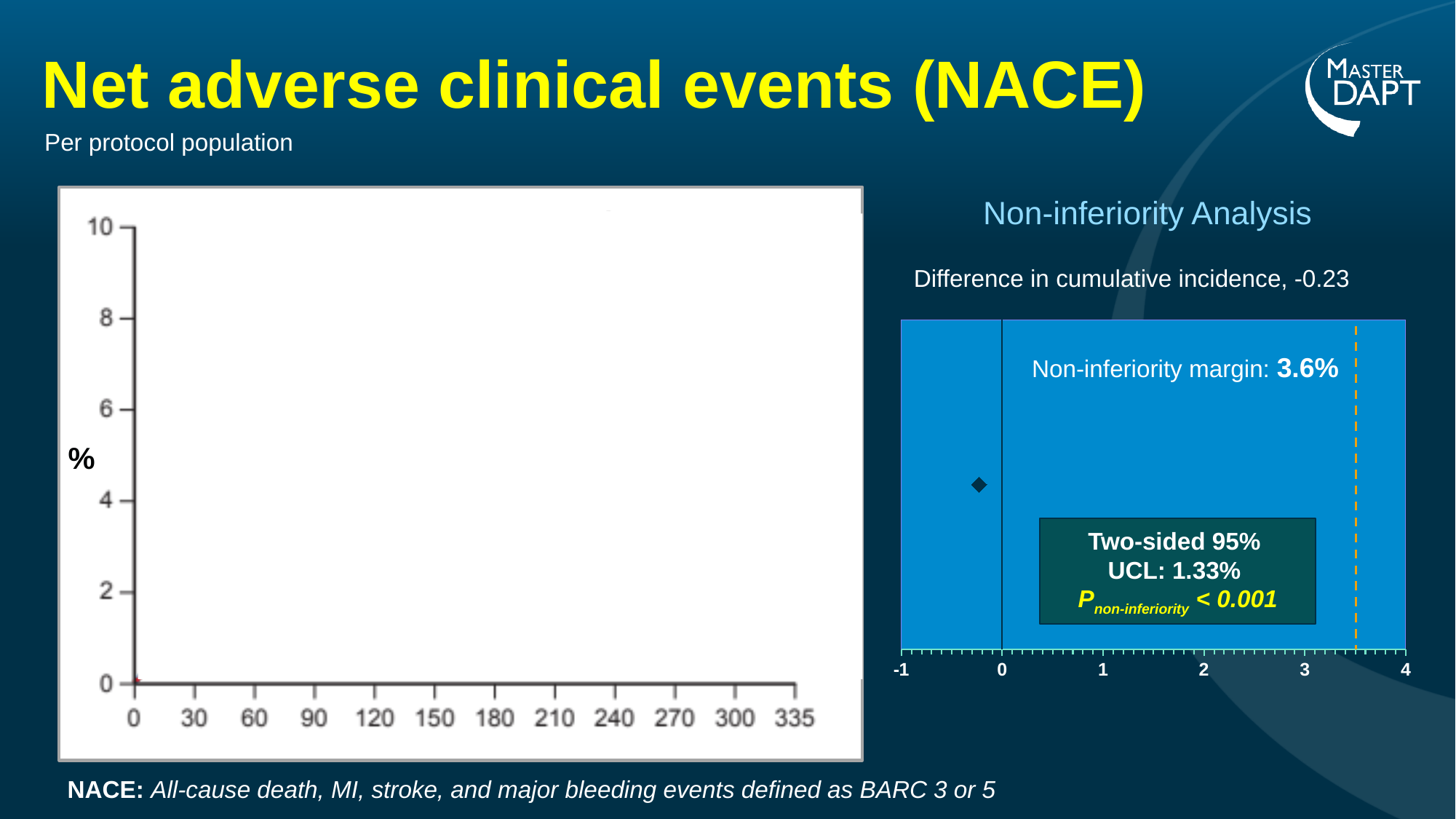
In the Non-inferiority Analysis chart, is the plotted point estimate greater or less than 0? less In the Non-inferiority Analysis chart, what is the lowest value labelled on the x axis? -1 In the Non-inferiority Analysis chart, what is the two-sided 95% UCL? 1.33% In the chart on the left of the slide, what is the highest value labelled on the x axis? 335 In the Non-inferiority Analysis chart, is the dashed non-inferiority margin line greater or less than 3 on the x axis? greater In the Non-inferiority Analysis chart, what is the difference in cumulative incidence shown? -0.23 In the Non-inferiority Analysis chart, what is the P value for non-inferiority? < 0.001 In the Non-inferiority Analysis chart, what is the non-inferiority margin? 3.6% In the Non-inferiority Analysis chart, is the 95% UCL of 1.33% greater or less than the non-inferiority margin of 3.6%? less